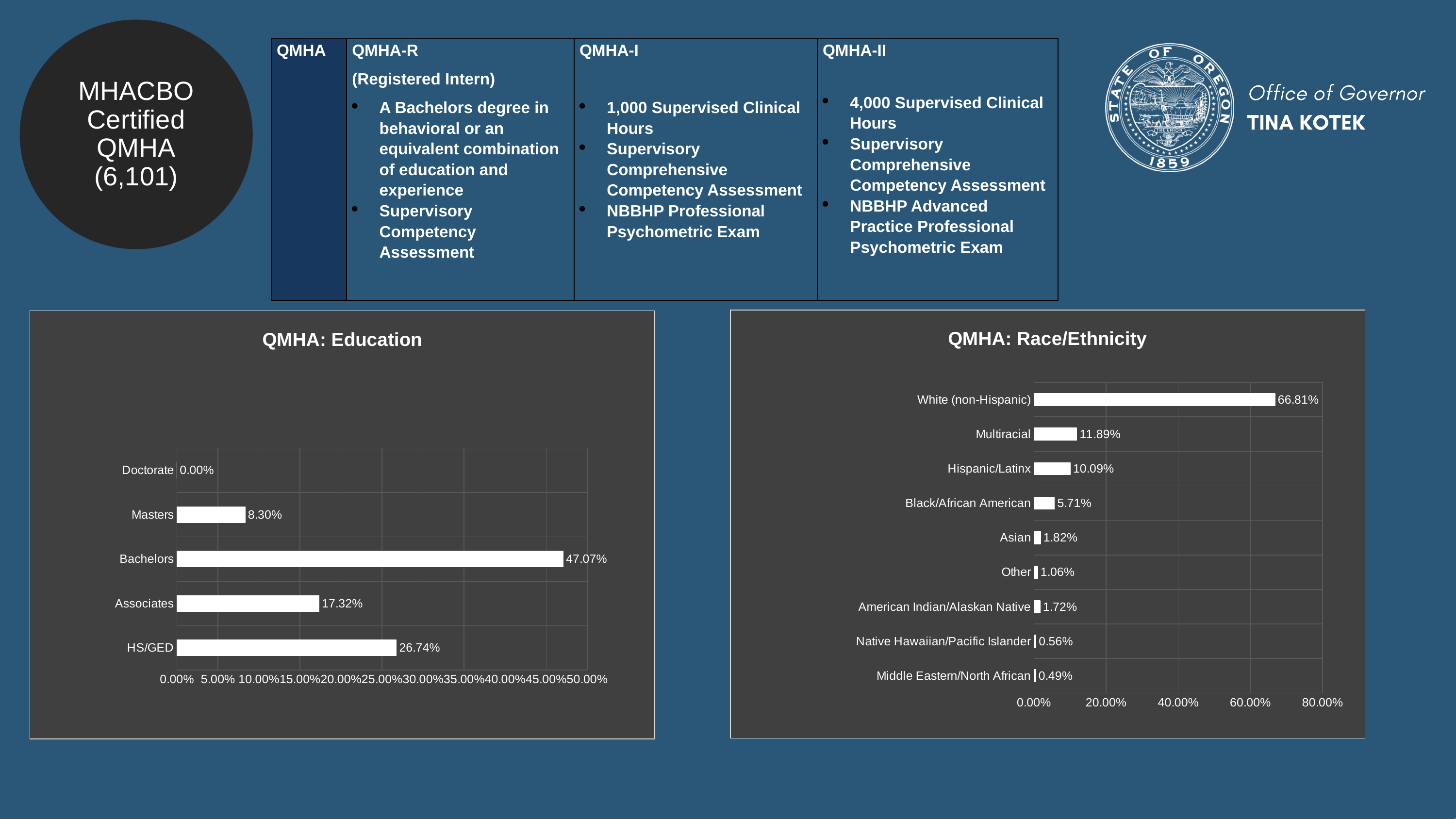
In the QMHA: Education chart, which category has the lowest value? Doctorate In the QMHA: Race/Ethnicity chart, how many race/ethnicity categories are shown? 9 In the QMHA: Race/Ethnicity chart, which is larger, Multiracial or Black/African American? Multiracial In the QMHA: Education chart, what is the difference between HS/GED and Associates? 9.42% In the QMHA: Education chart, is the value for Masters greater or less than 10.00%? less In the QMHA: Race/Ethnicity chart, which category has the lowest value? Middle Eastern/North African In the QMHA: Education chart, what is the value for Bachelors? 47.07% In the QMHA: Education chart, how many education categories are shown? 5 What kind of chart is the QMHA: Race/Ethnicity chart? Bar chart In the QMHA: Education chart, which category has the highest value? Bachelors In the QMHA: Race/Ethnicity chart, what is the value for Hispanic/Latinx? 10.09% In the QMHA: Race/Ethnicity chart, which category has the highest value? White (non-Hispanic)